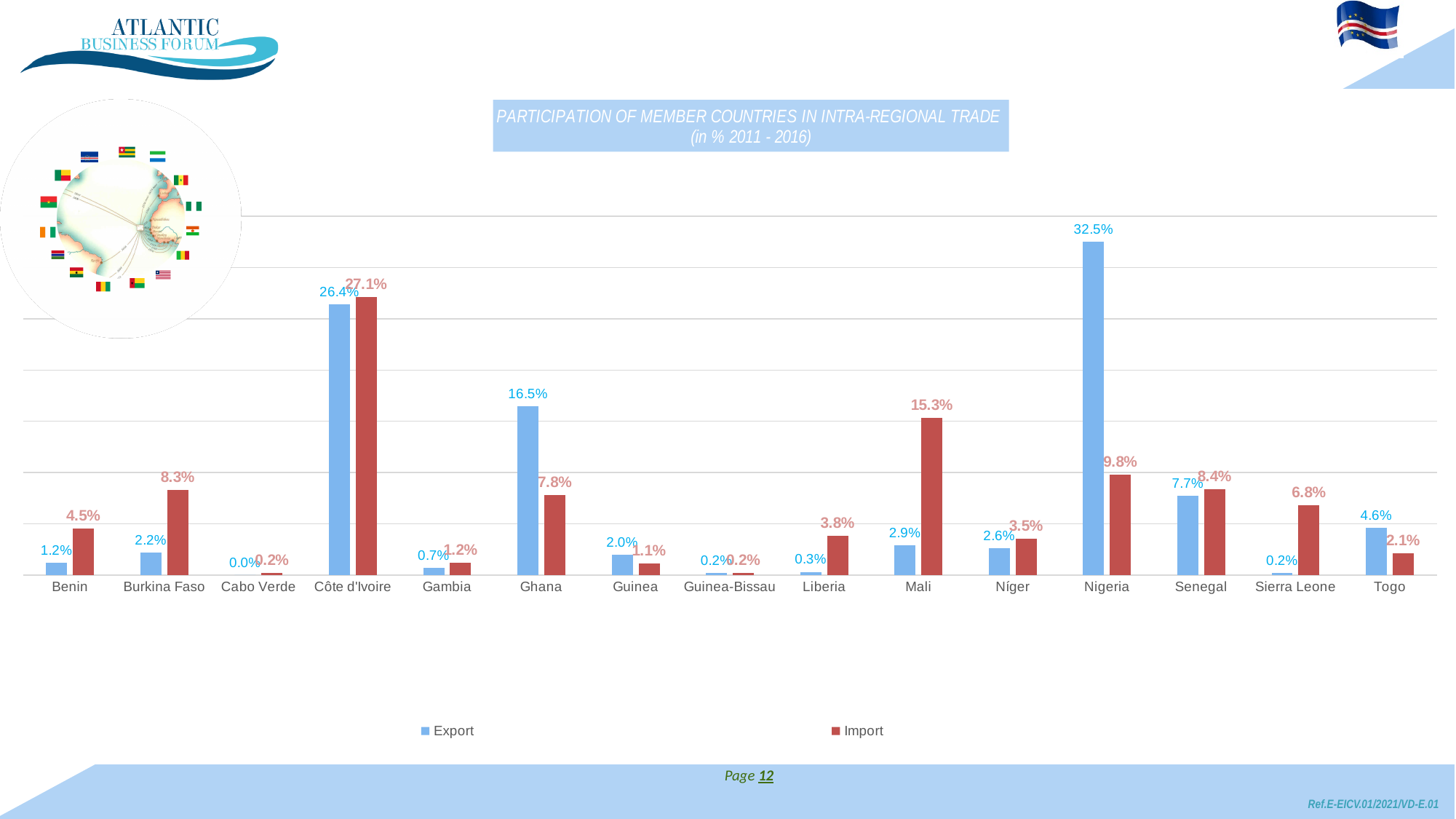
What type of chart is shown on the slide? Bar chart What is the Import value for Sierra Leone? 6.8% Which country has the lowest Export value? Cabo Verde What is the Import value for Mali? 15.3% What is the Export value for Ghana? 16.5% What is the Export value for Nigeria? 32.5% What is the difference between the Import and Export values for Côte d'Ivoire? 0.7% Which is larger for Senegal, the Export value or the Import value? Import Which country has the highest Import value? Côte d'Ivoire How many countries are shown on the x axis? 15 How many series does the legend list? 2 Which country has the highest Export value? Nigeria